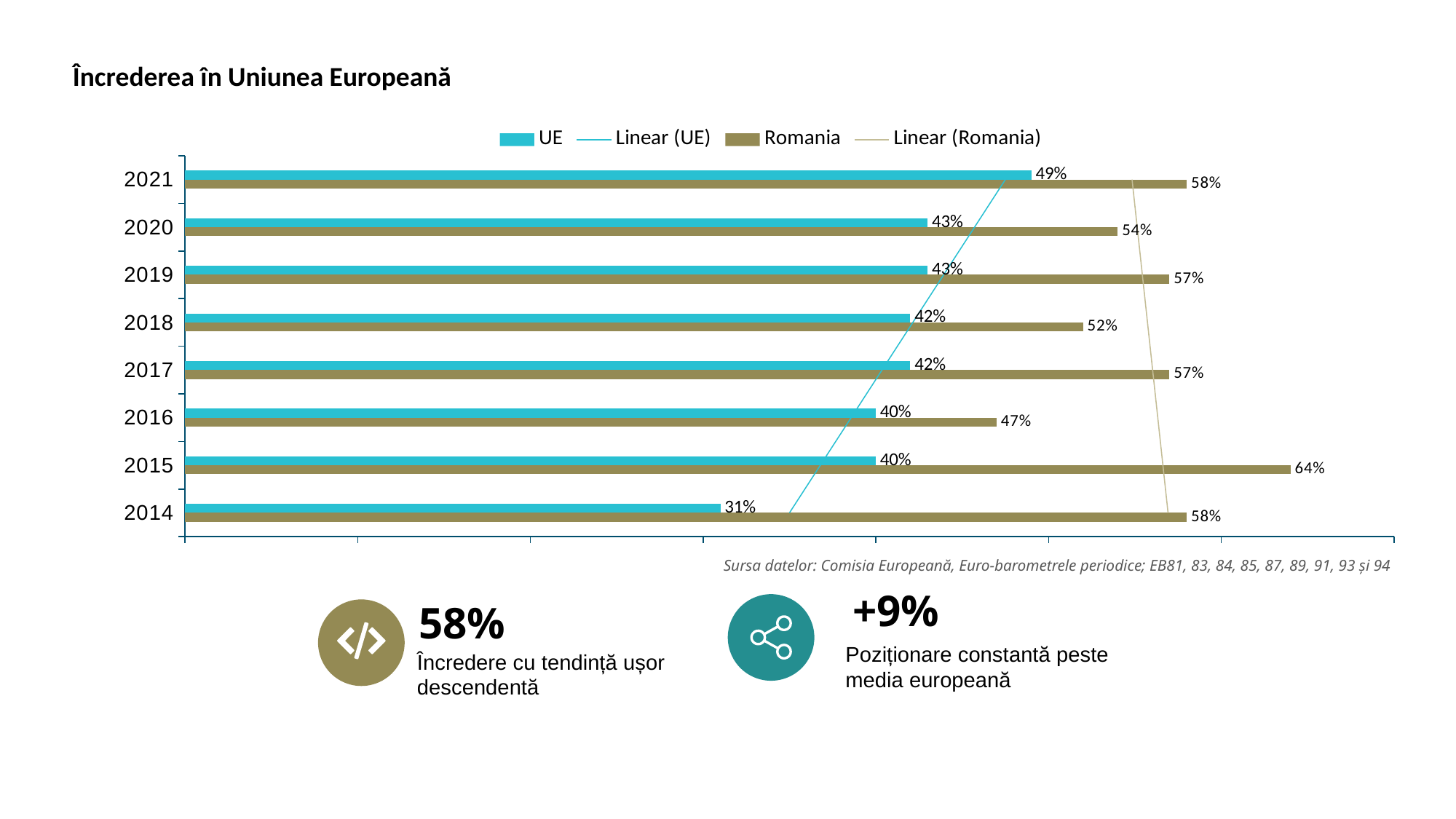
What is the value for UE in 2014? 31% What is the value for Romania in 2018? 52% How many entries does the legend list? 4 What is the difference between the Romania and UE values in 2021? 9% What is the value for Romania in 2015? 64% In which year is the UE value lowest? 2014 What is the value for UE in 2021? 49% In which year is the Romania value lowest? 2016 In which year is the Romania value highest? 2015 What kind of chart is shown on the slide? Bar chart Which is larger in 2016, the UE value or the Romania value? Romania How many years are shown on the chart? 8